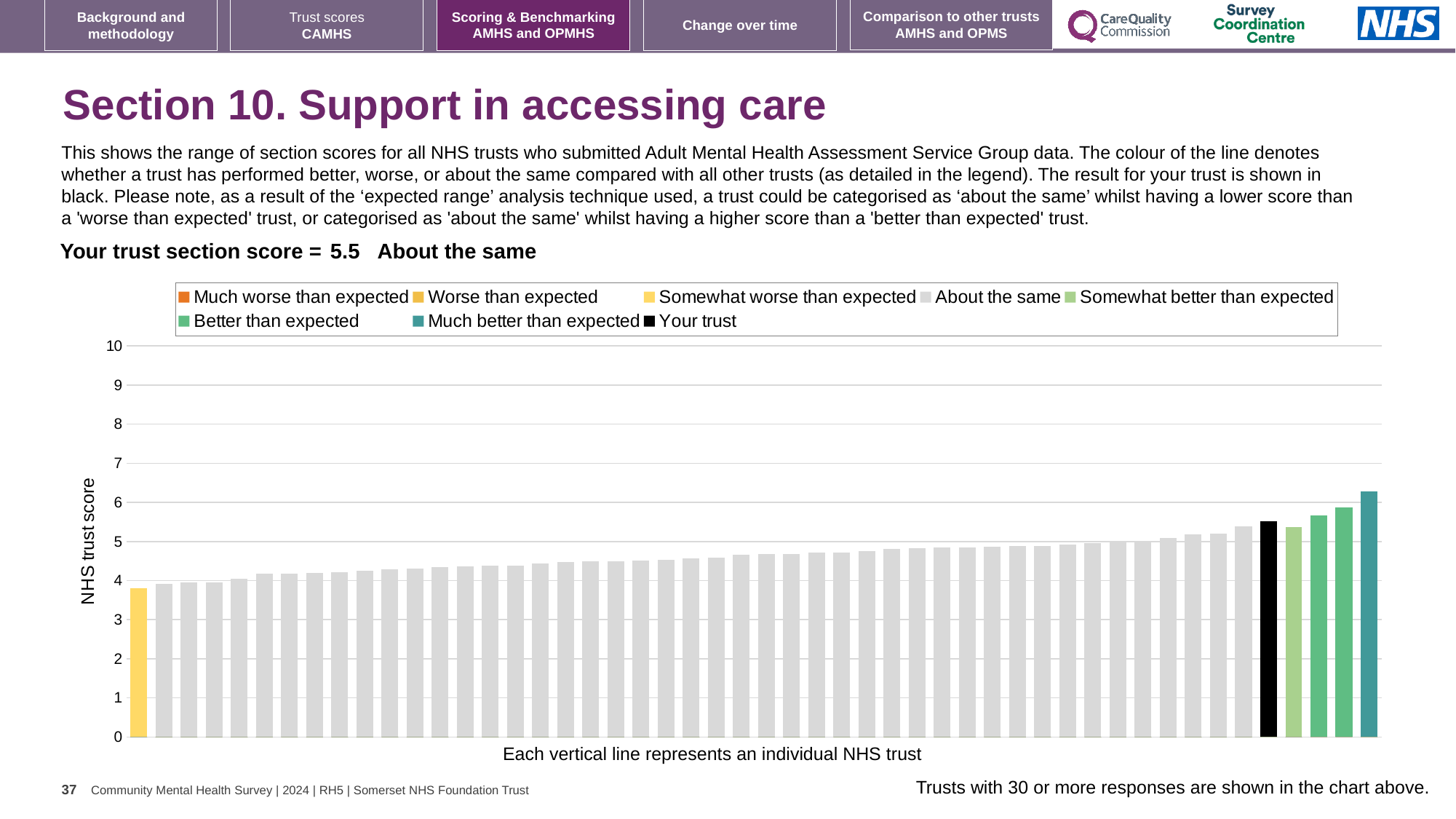
Is the value for your trust greater or less than 5? greater What colour is the bar representing your trust? black What kind of chart is shown on the slide? bar chart Is your trust's bar higher or lower than the tallest bar on the chart? lower Is the value of the tallest bar on the chart greater or less than 7? less What is the section score for your trust? 5.5 Is the value of the tallest bar on the chart greater or less than 6? greater What is the label on the y axis of the chart? NHS trust score Which category is your trust's section score placed in? About the same Do the bar values rise or fall from left to right along the x axis? rise How many entries does the chart legend list? 8